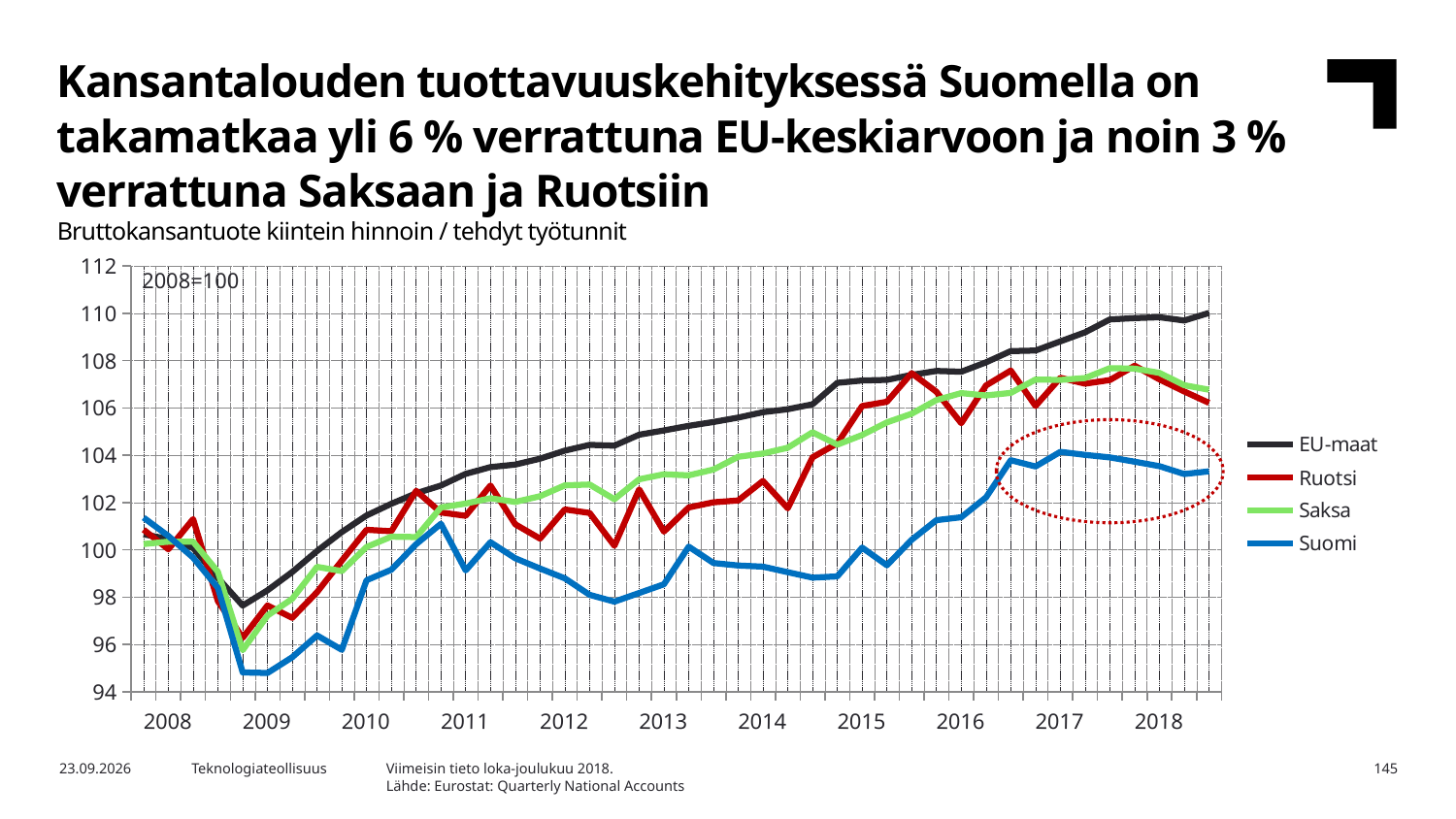
Does the EU-maat series rise or fall from 2010 to 2018? rise What base year and value does the annotation in the chart give for the index? 2008=100 Is the value for Suomi at the end of 2018 greater or less than 104? less Which series has the lowest value at the end of 2018? Suomi What kind of chart is shown on the slide? line chart How many series does the legend list? 4 Which series are listed in the legend? EU-maat, Ruotsi, Saksa, Suomi Is the lowest value for Suomi in 2009 greater or less than 96? less Is the value for EU-maat at the end of 2018 greater or less than 108? greater Which series has the highest value at the end of 2018? EU-maat How many year labels are shown on the x axis? 11 At the end of 2018, which is larger, the value for Saksa or the value for Suomi? Saksa